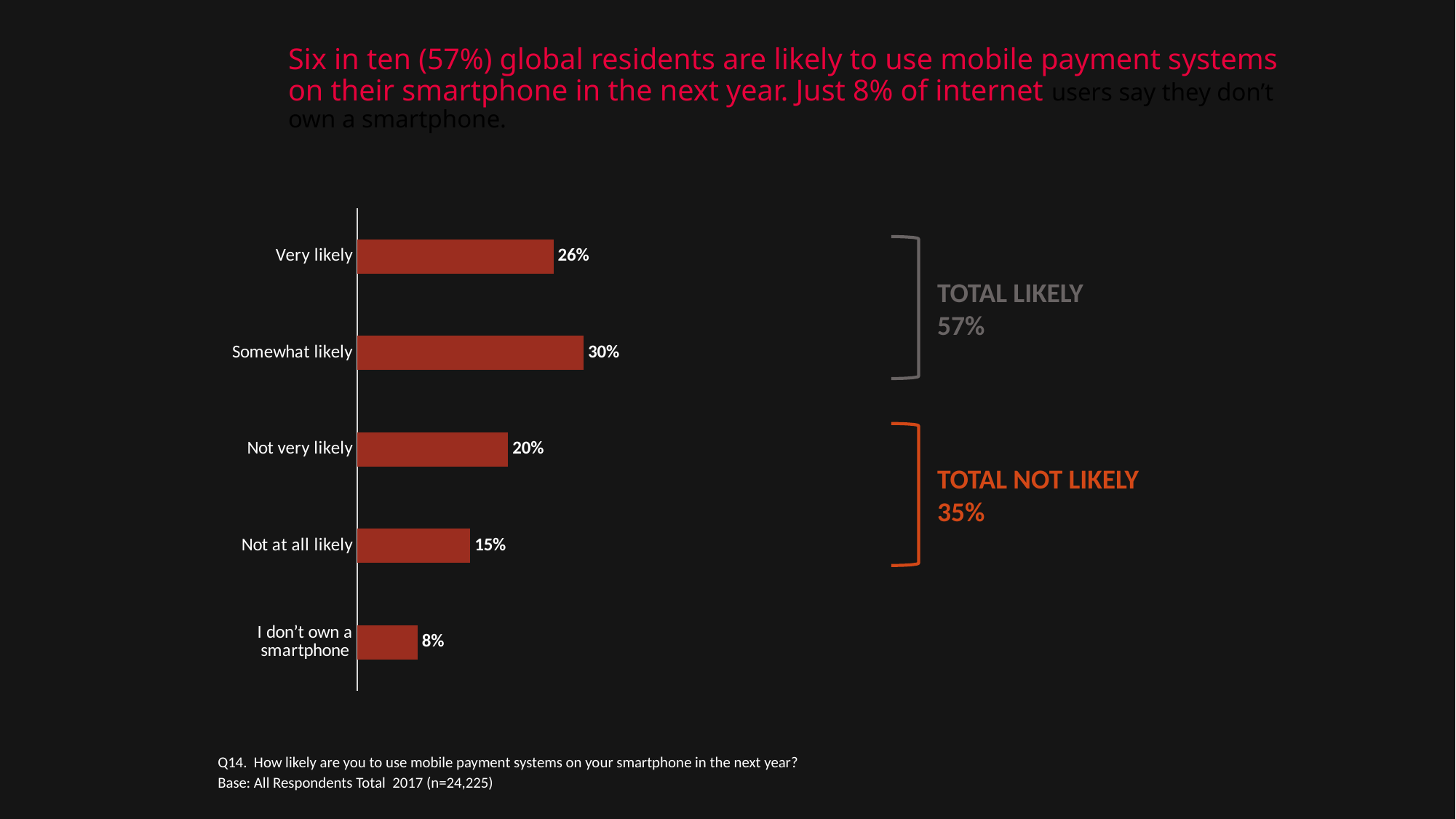
What is the difference between the 'Somewhat likely' and 'Very likely' values? 4% What is the difference between 'Not very likely' and 'Not at all likely'? 5% What percentage of respondents are very likely to use mobile payment systems on their smartphone in the next year? 26% What kind of chart is shown on the slide? Bar chart What is the value for 'Not at all likely'? 15% What percentage of respondents say they don't own a smartphone? 8% How many categories are shown in the chart? 5 Which category has the highest value? Somewhat likely What is the value for 'Somewhat likely'? 30% Which is larger, the value for 'Not very likely' or the value for 'Not at all likely'? Not very likely Which category has the lowest value? I don't own a smartphone What is the 'TOTAL NOT LIKELY' figure shown next to the chart? 35%